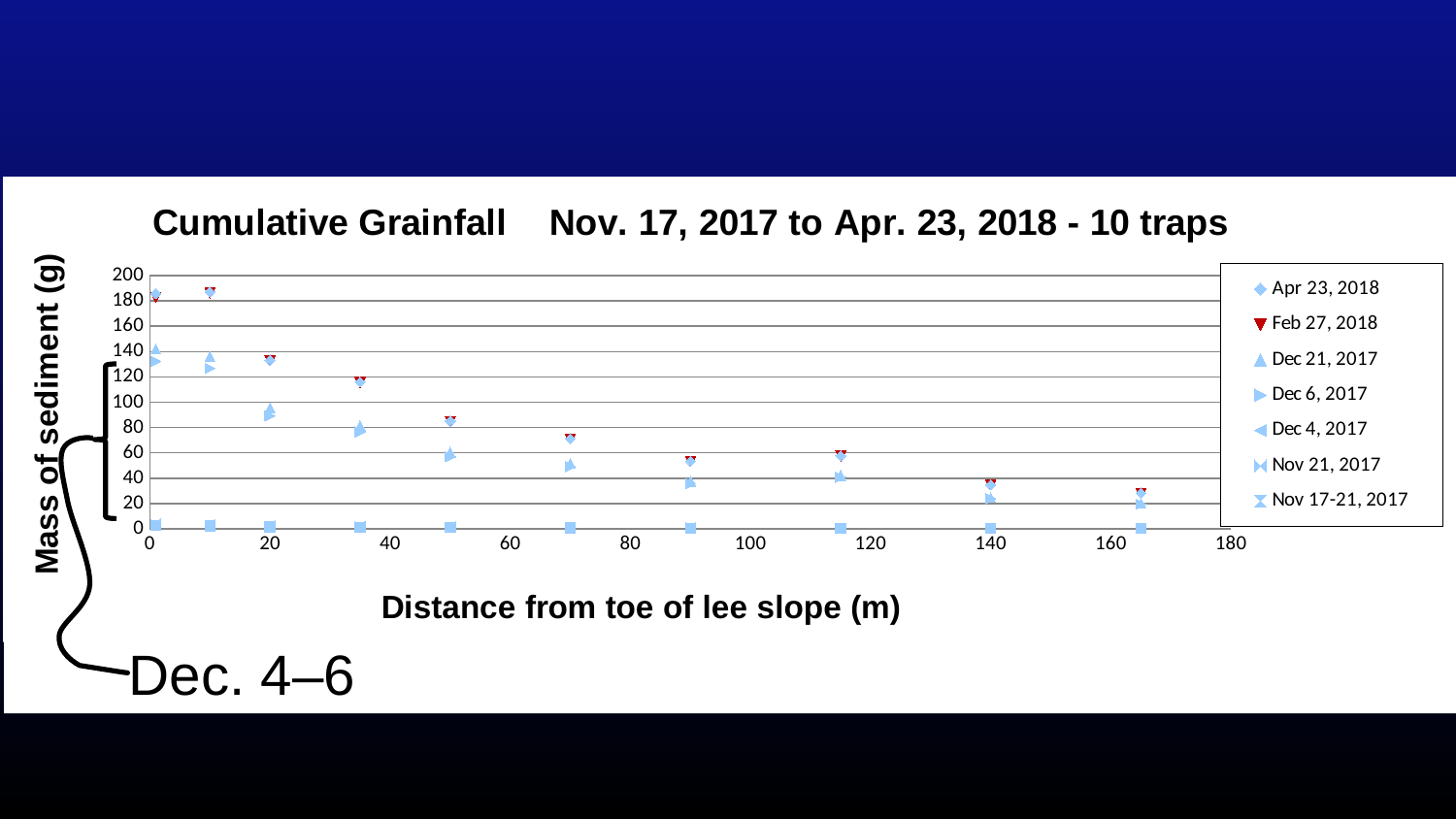
Is the Feb 27, 2018 value at a distance of 165 m greater or less than 40? less Is the Feb 27, 2018 value at a distance of 50 m greater or less than 100? less How many trap positions (distances) are plotted along the x axis? 10 How many series does the legend list? 7 Do the Feb 27, 2018 values rise or fall as distance from the toe of the lee slope increases? Fall Which is larger for Feb 27, 2018: the value at 20 m or the value at 35 m? 20 m Is the Dec 21, 2017 value at a distance of 20 m greater or less than 80? greater What kind of chart is shown on the slide? Scatter chart At which distance is the Feb 27, 2018 value lowest? 165 m What is the title of the x axis? Distance from toe of lee slope (m)